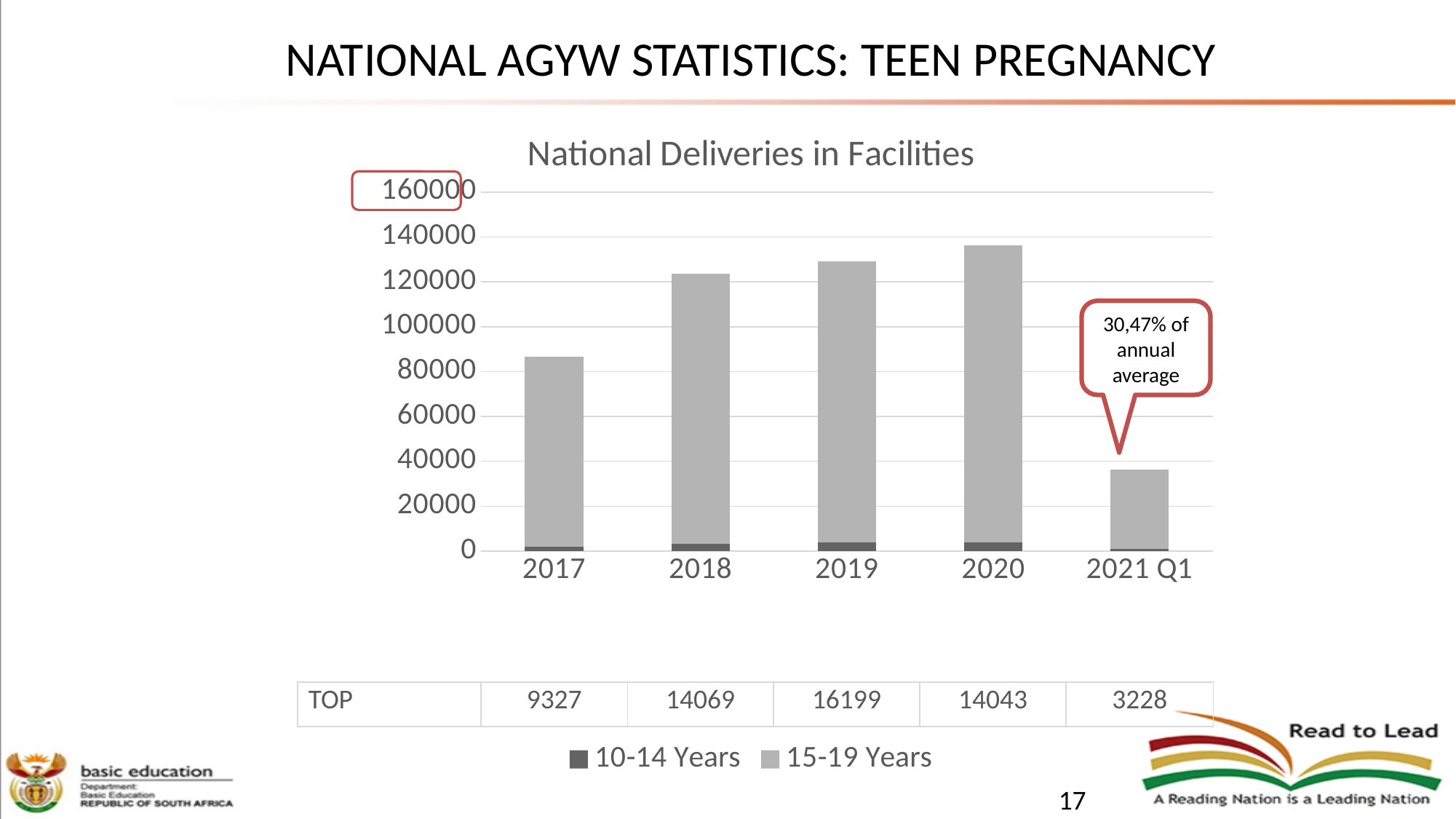
Is the total bar for 2017 greater or less than 100000? less How many series does the legend list? 2 How many categories are shown on the x axis? 5 What is the title of the chart? National Deliveries in Facilities Which bar is taller, 2018 or 2019? 2019 Which category has the shortest bar? 2021 Q1 What kind of chart is shown on the slide? Stacked bar chart What TOP value is shown in the table row for 2019? 16199 Is the total bar for 2021 Q1 greater or less than 40000? less Is the total bar for 2020 greater or less than 120000? greater Do the bar totals rise or fall from 2017 to 2020? Rise Which year has the tallest bar? 2020